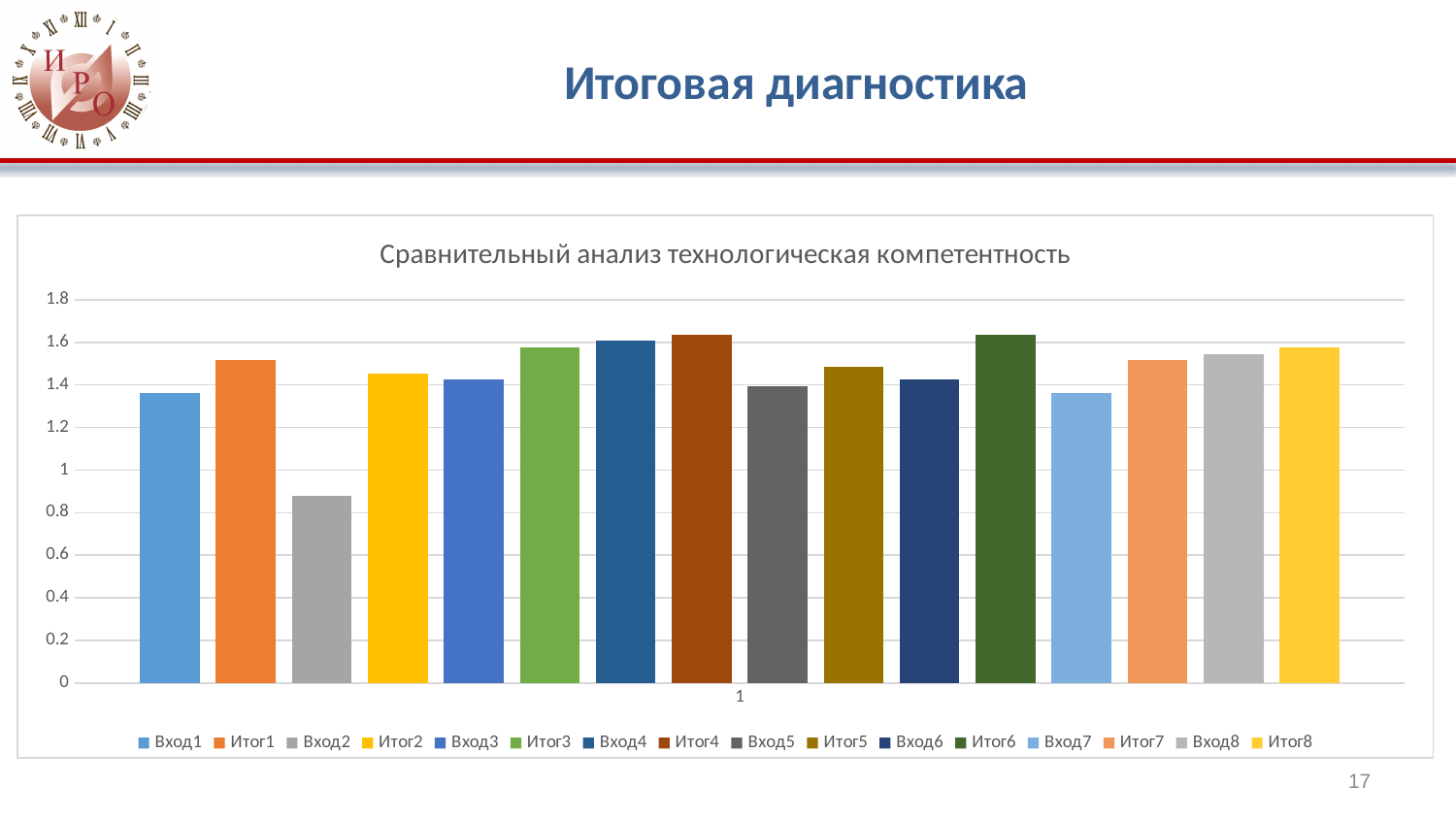
Is the value for Вход2 greater or less than 1? less Which is larger, Вход6 or Итог6? Итог6 What is the title of the chart? Сравнительный анализ технологическая компетентность Which series has the lowest value? Вход2 Which is larger, Вход2 or Итог2? Итог2 What type of chart is shown on the slide? bar chart Is the value for Итог3 greater or less than 1.4? greater How many series does the legend list? 16 Is the value for Вход1 greater or less than 1.4? less Which is larger, Вход1 or Итог1? Итог1 How many categories are shown on the x axis? 1